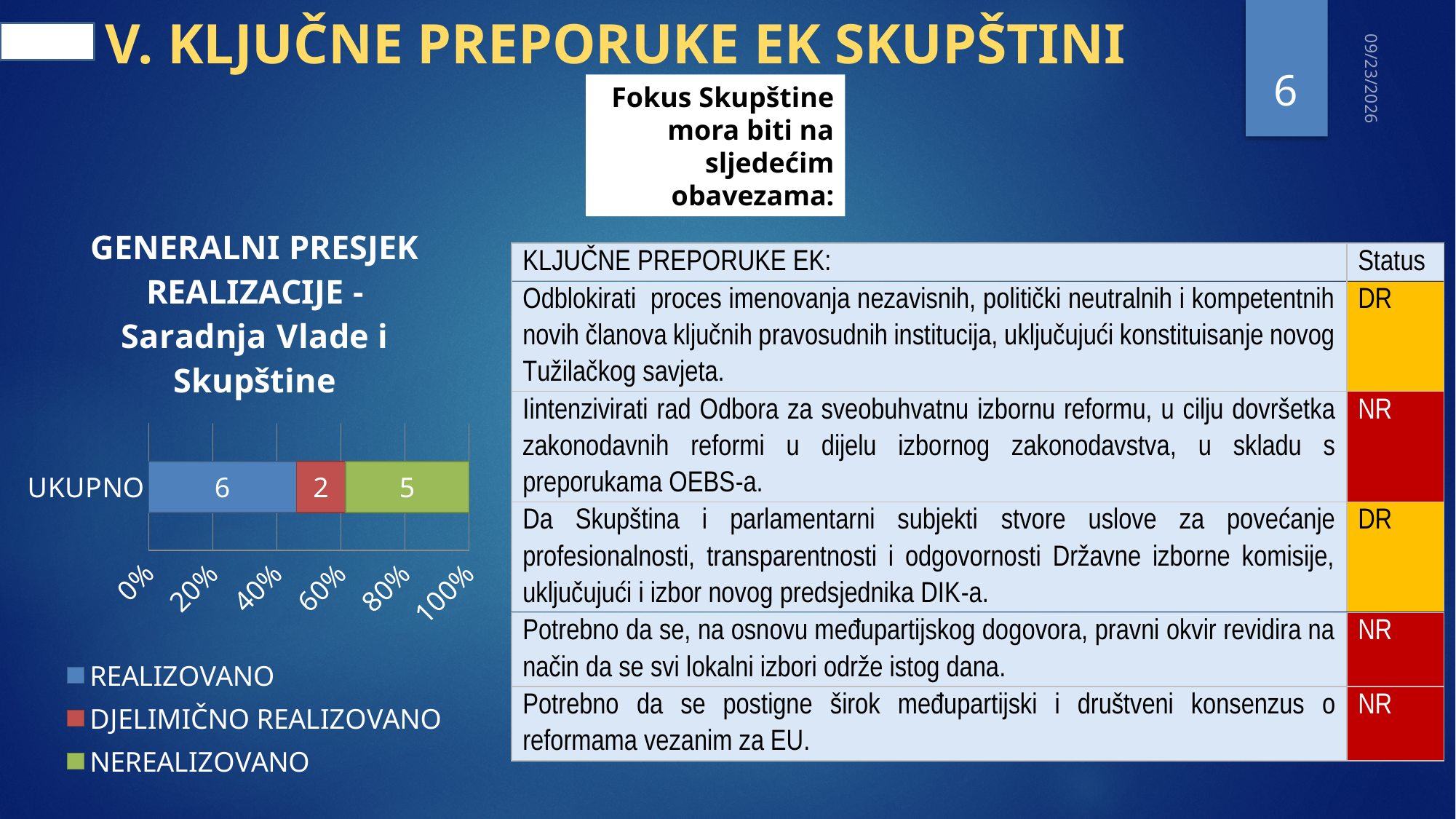
Which series has the highest value in the UKUPNO bar? REALIZOVANO Which series has the lowest value in the UKUPNO bar? DJELIMIČNO REALIZOVANO What is the difference between the REALIZOVANO and NEREALIZOVANO values? 1 What value is shown for DJELIMIČNO REALIZOVANO in the UKUPNO bar? 2 What value is shown for REALIZOVANO in the UKUPNO bar? 6 What is the total of the three segments in the UKUPNO bar? 13 Which is larger, the value for REALIZOVANO or the value for DJELIMIČNO REALIZOVANO? REALIZOVANO What kind of chart is shown on the slide? Stacked bar chart What value is shown for NEREALIZOVANO in the UKUPNO bar? 5 What is the difference between the NEREALIZOVANO and DJELIMIČNO REALIZOVANO values? 3 What is the title of the chart? GENERALNI PRESJEK REALIZACIJE - Saradnja Vlade i Skupštine How many series does the chart legend list? 3